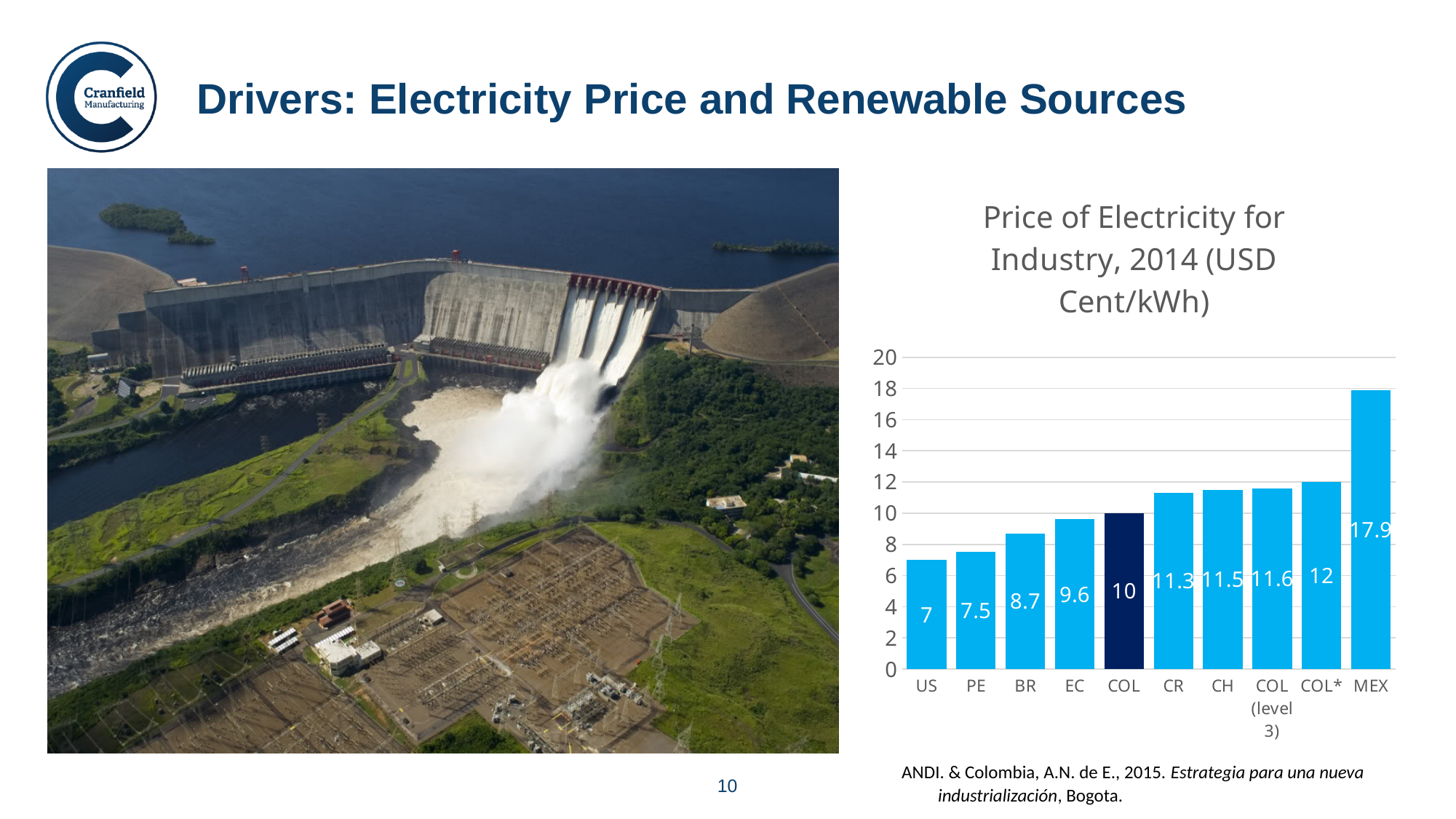
What is the value shown for MEX? 17.9 Which country has the lowest price of electricity for industry? US Which country has the highest price of electricity for industry? MEX Which has a higher value, EC or CR? CR Which bar is shown in a darker colour than the others? COL What is the difference between the values for BR and PE? 1.2 Is the value for COL* greater or less than 10? greater How many countries/categories are shown on the x axis? 10 What kind of chart is shown on the slide? Bar chart What is the price of electricity for industry in the US? 7 What is the value shown for COL (level 3)? 11.6 What is the difference between the values for MEX and COL? 7.9